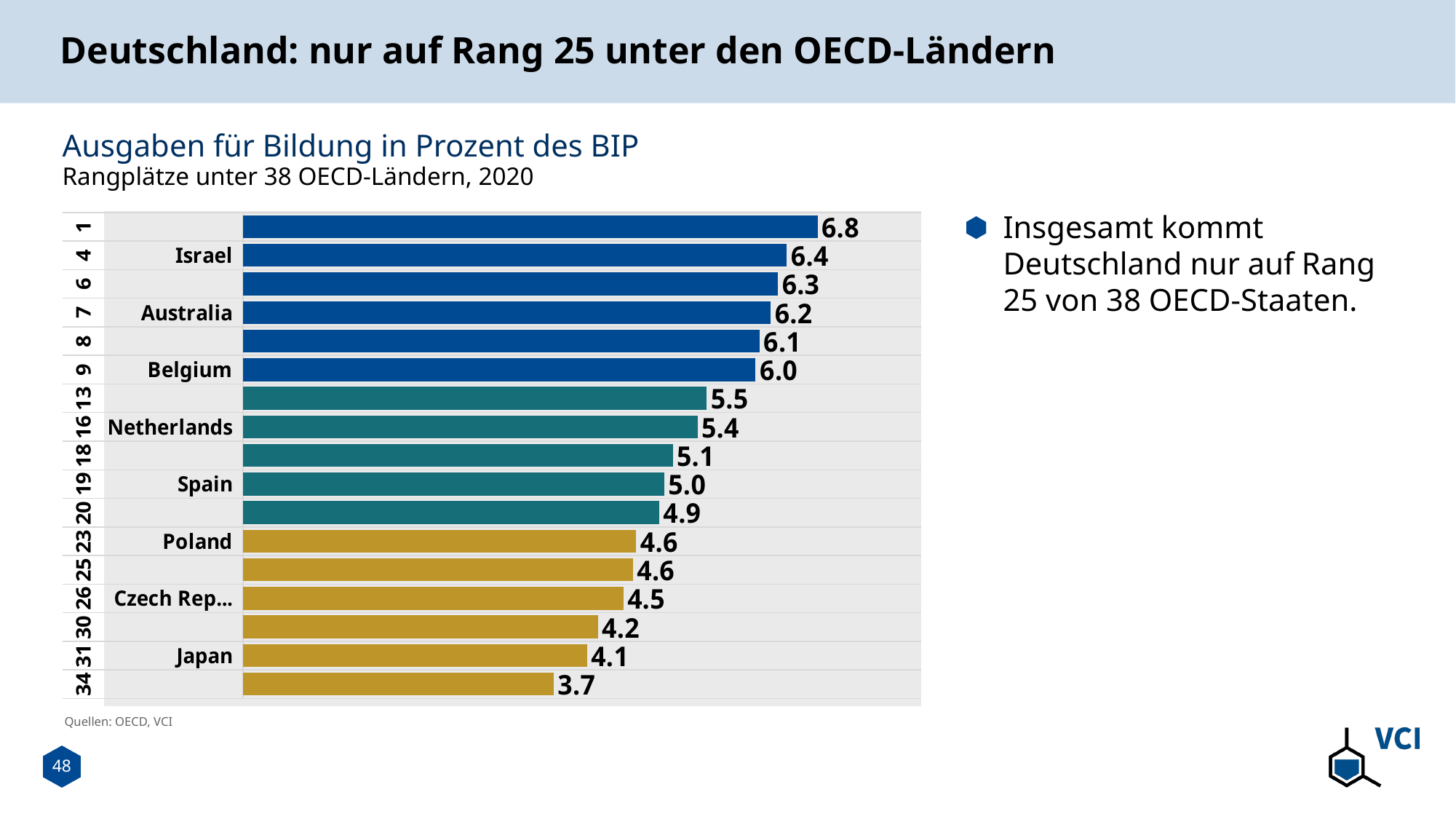
What is the value for Japan? 4.1 What is the value for Israel? 6.4 What is the value of the bar at rank 25? 4.6 What is the difference between the values for Israel and Japan? 2.3 Which has the larger value, Poland or Czech Rep...? Poland Which of the labelled countries has the highest value? Israel What is the value for the Netherlands? 5.4 How many bars are shown in the chart? 17 What is the lowest value shown in the chart? 3.7 What kind of chart is shown on the slide? Bar chart What is the value for Australia? 6.2 What is the value for Belgium? 6.0